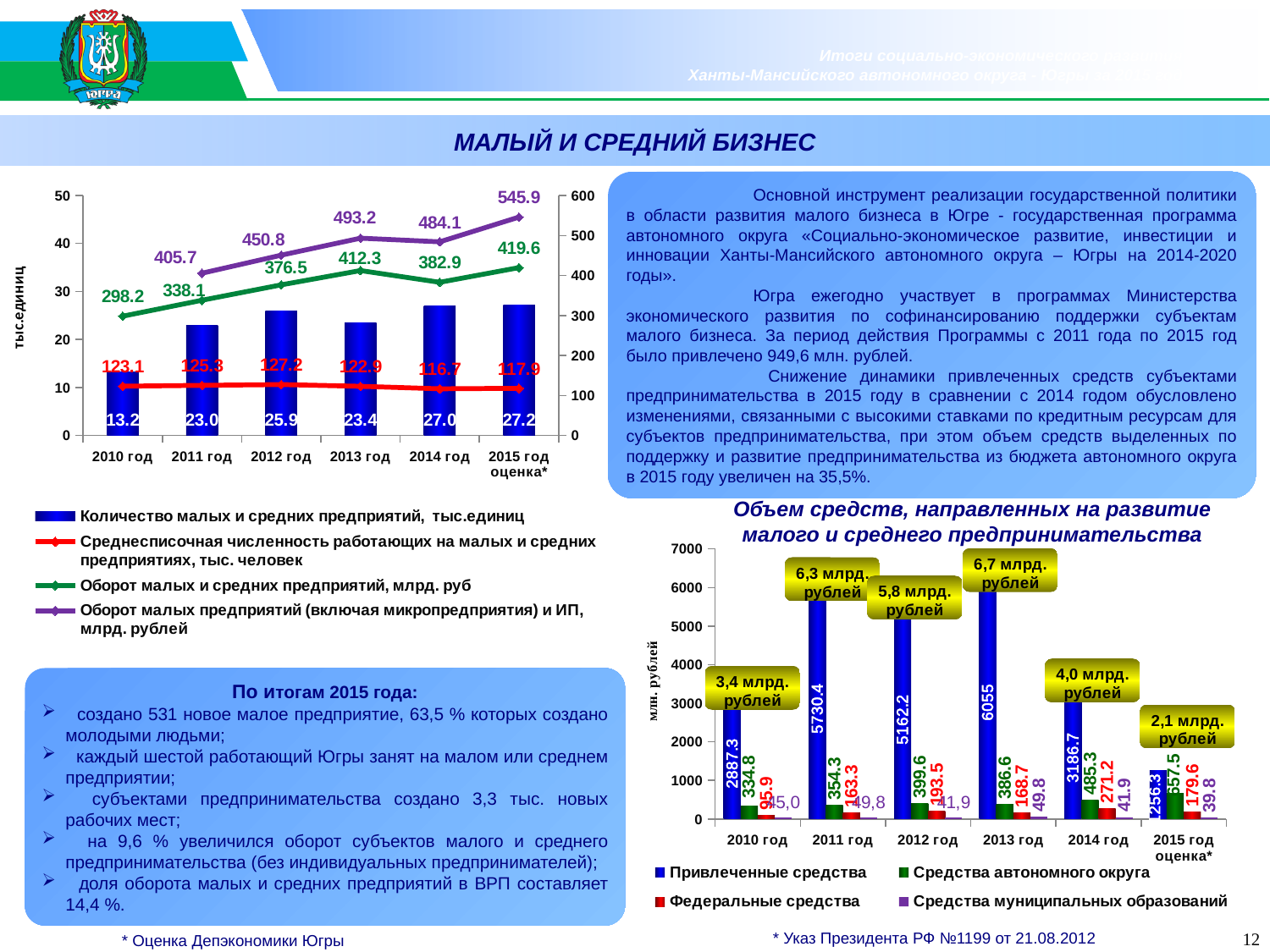
On the left chart, which year has the lowest number of small and medium enterprises (blue bars)? 2010 год On the chart 'Объем средств, направленных на развитие малого и среднего предпринимательства', what is the value of Средства автономного округа in 2015 год оценка*? 657.5 On the chart 'Объем средств, направленных на развитие малого и среднего предпринимательства', what is the total amount of funds shown for 2011 год? 6,3 млрд. рублей On the left chart, what is the difference between the turnover of small and medium enterprises in 2015 год оценка* and in 2010 год? 121.4 On the chart 'Объем средств, направленных на развитие малого и среднего предпринимательства', which is larger: Федеральные средства in 2014 год or in 2012 год? 2014 год On the chart 'Объем средств, направленных на развитие малого и среднего предпринимательства', in which year is Привлеченные средства highest? 2013 год On the left chart, does the average number of employees (red line) rise or fall from 2012 год to 2014 год? fall On the chart 'Объем средств, направленных на развитие малого и среднего предпринимательства', what is the value of Привлеченные средства in 2013 год? 6055 On the left chart, what is the turnover of small and medium enterprises (Оборот малых и средних предприятий) in 2013 год? 412.3 On the chart 'Объем средств, направленных на развитие малого и среднего предпринимательства', how many years are shown on the x axis? 6 On the left chart, how many series does the legend list? 4 On the left chart, what is the number of small and medium enterprises (Количество малых и средних предприятий) for 2015 год оценка*? 27.2